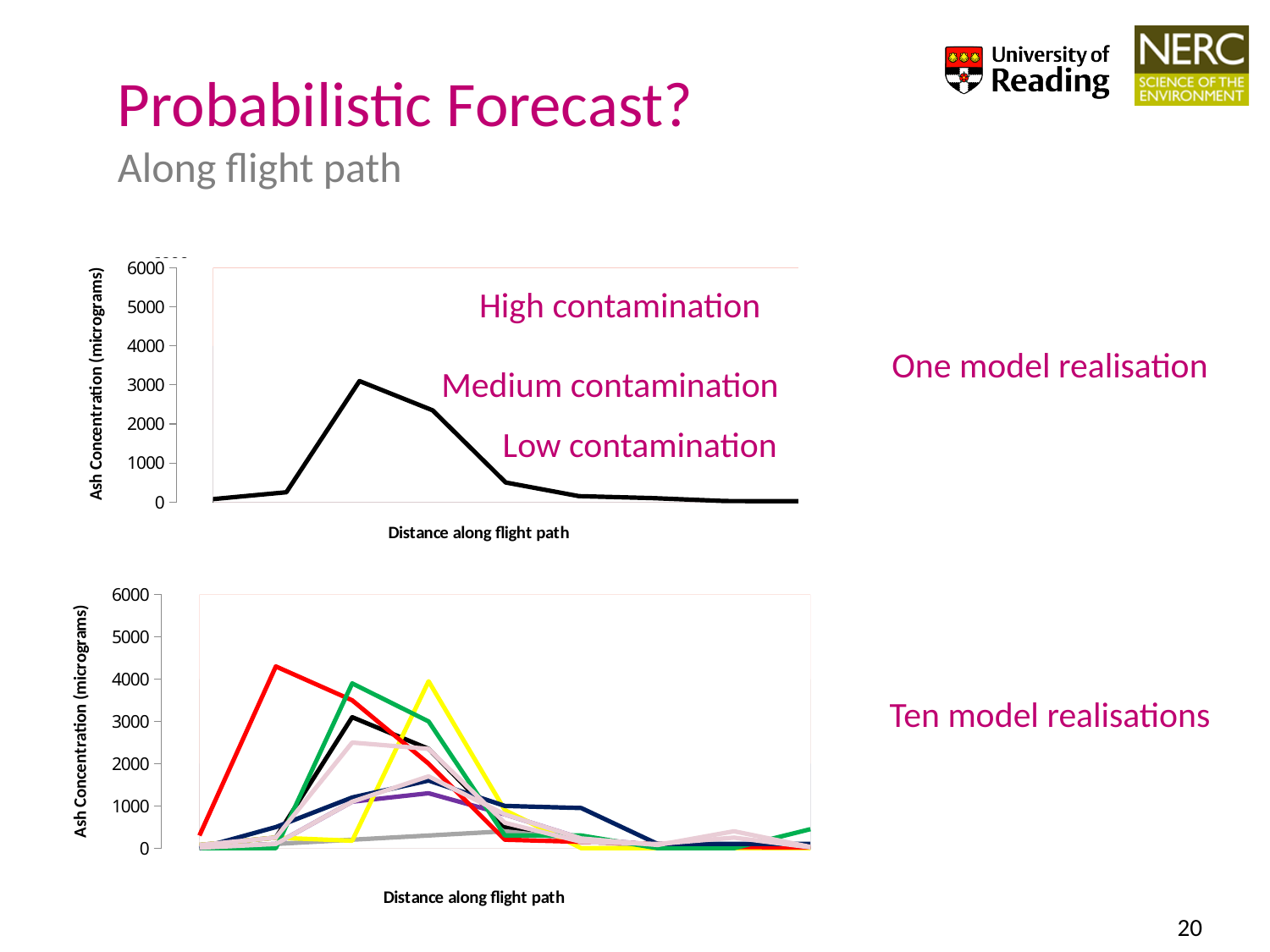
On the bottom chart, is the peak of the red line higher or lower than the peak of the purple line? higher On the top chart, is the peak value of the black line greater or less than 2000? greater On the top chart, is the peak value of the black line greater or less than 4000? less What kind of chart is the bottom chart on the slide? line chart What kind of chart is the top chart on the slide? line chart What is the title of the horizontal axis on the bottom chart? Distance along flight path On the bottom chart, is the peak value of the grey line greater or less than 1000? less On the top chart, do the values rise or fall along the x axis after the peak? fall On the bottom chart, which coloured line reaches the highest peak? red What is the title of the vertical axis on the top chart? Ash Concentration (micrograms)